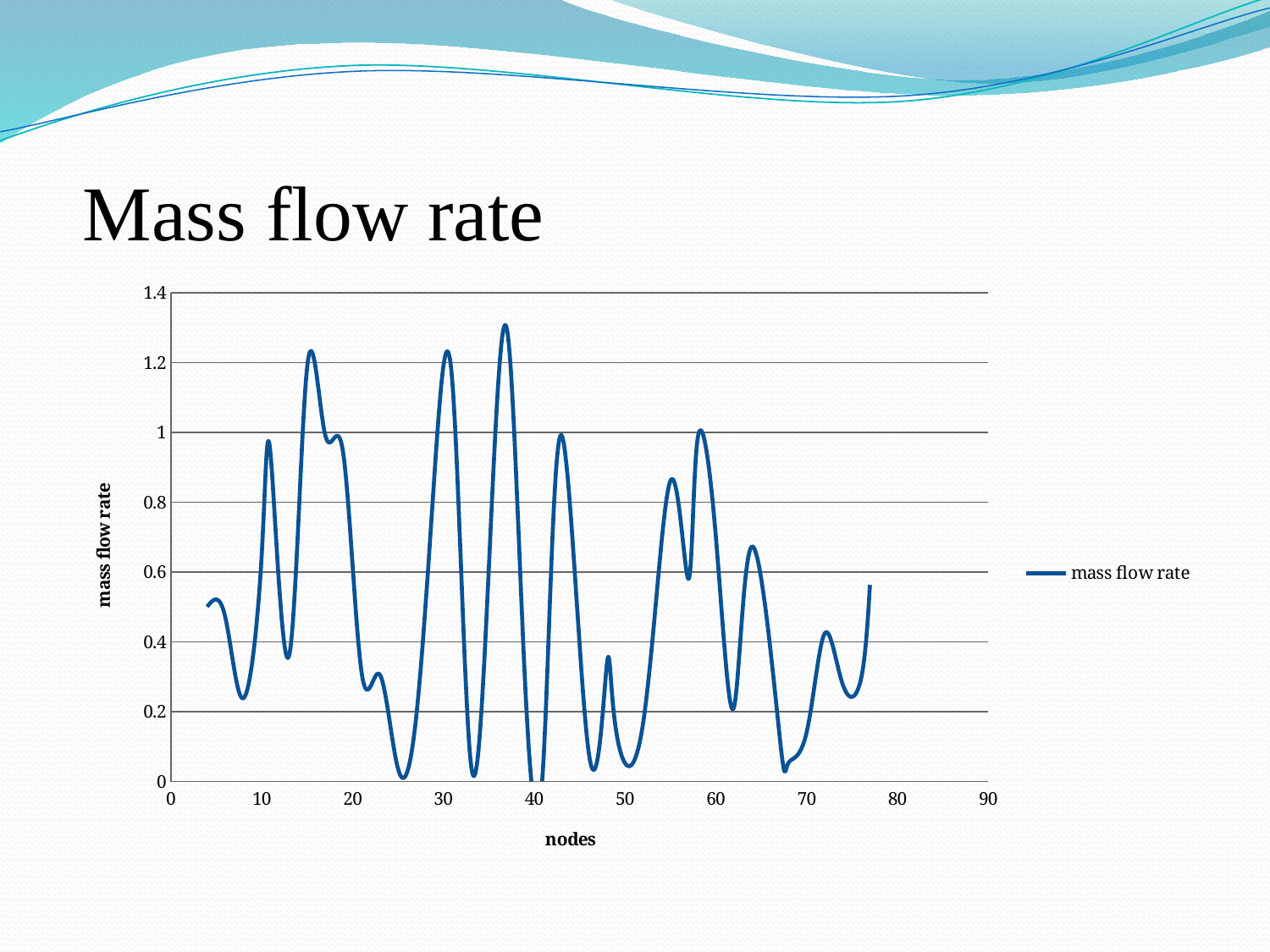
Does the line rise or fall between node 20 and node 26? fall Does the line reach its highest value before or after node 40? before How many series does the legend list? 1 Is the peak value of the line near node 37 greater or less than 1.2? greater What kind of chart is shown on the slide? line chart Is the value of the line near node 4 greater or less than 0.4? greater Is the value of the line near node 26 greater or less than 0.2? less What is the label of the x axis? nodes